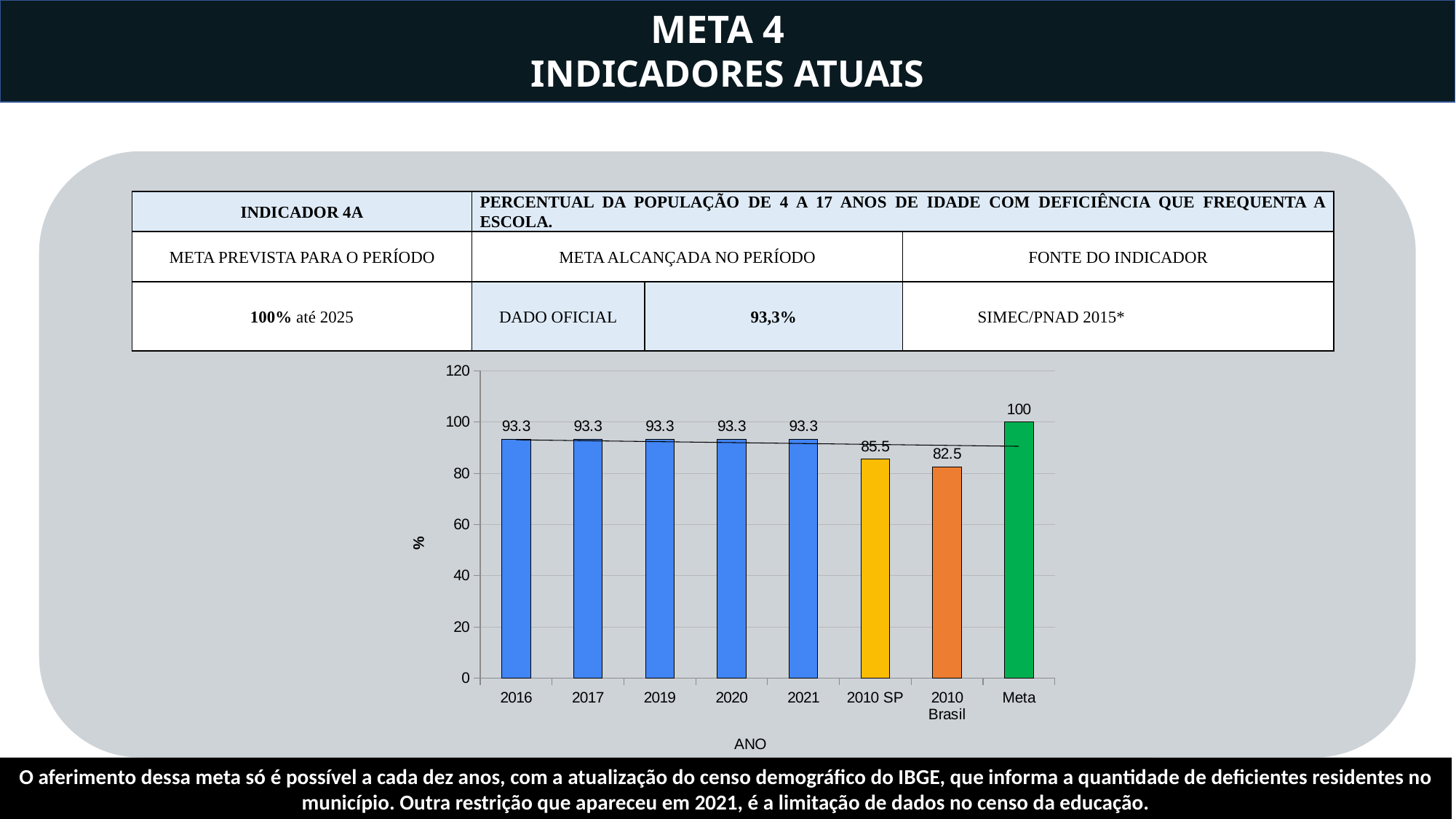
What is the value for 2016? 93.3 What is the label of the x axis of the chart? ANO What is the value for Meta? 100 What is the difference between the Meta value and the 2021 value? 6.7 What kind of chart is shown on the slide? bar chart How many bars are shown in the chart? 8 What is the value for 2010 Brasil? 82.5 What is the difference between the 2010 SP value and the 2010 Brasil value? 3 Which is larger, the value for 2010 SP or the value for 2010 Brasil? 2010 SP Which category has the lowest value? 2010 Brasil What is the value for 2010 SP? 85.5 Which category has the highest value? Meta